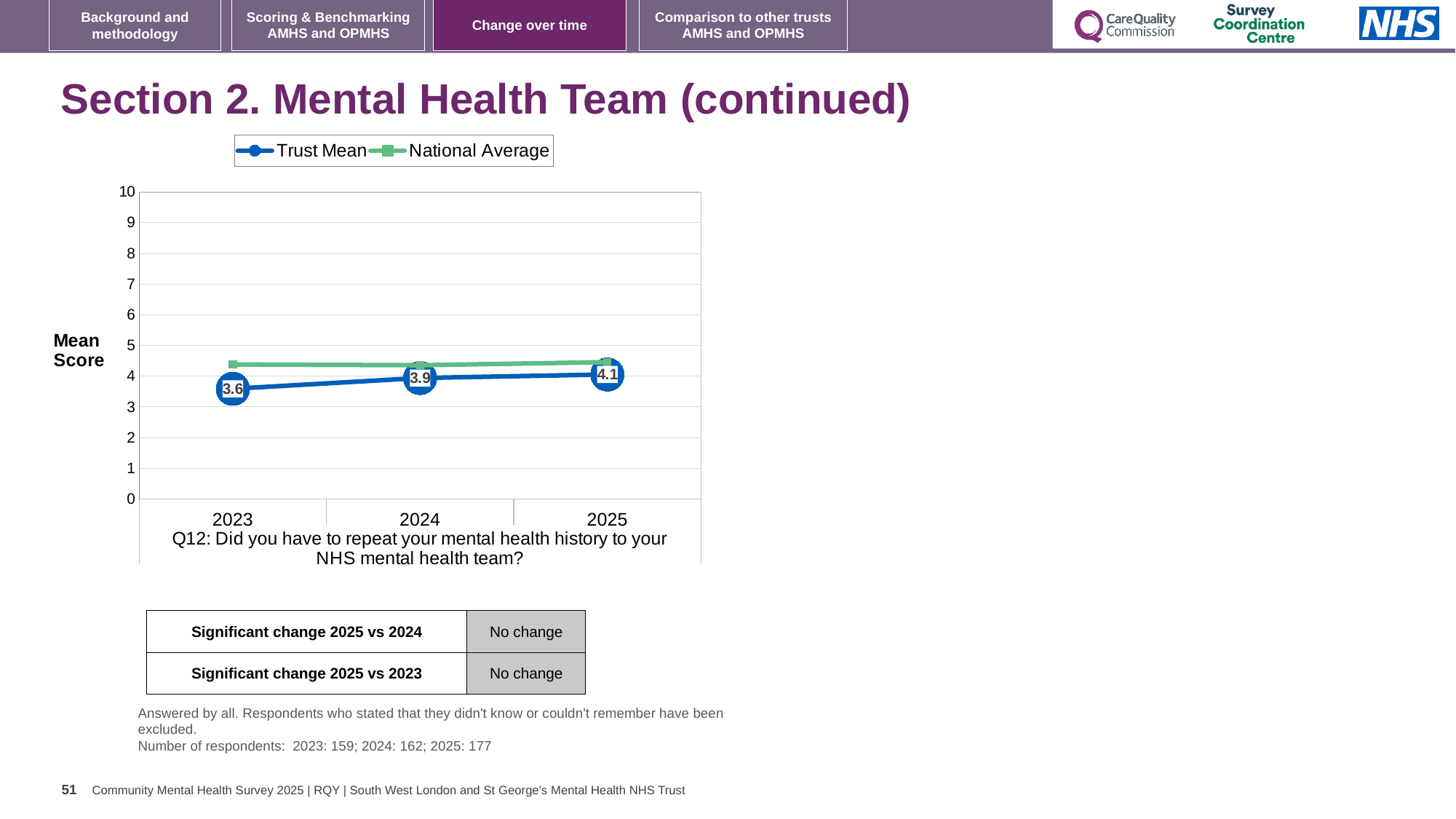
What is the Trust Mean score for 2024? 3.9 Which is larger in 2023, the Trust Mean or the National Average? National Average How many years are shown on the x axis? 3 In which year is the Trust Mean lowest? 2023 What is the difference between the Trust Mean in 2025 and in 2023? 0.5 Is the National Average value for 2024 greater or less than 4? greater How many series does the legend list? 2 What is the Trust Mean score for 2025? 4.1 What kind of chart is shown on the slide? Line chart Does the Trust Mean rise or fall from 2023 to 2025? Rise What is the Trust Mean score for 2023? 3.6 In which year is the Trust Mean highest? 2025